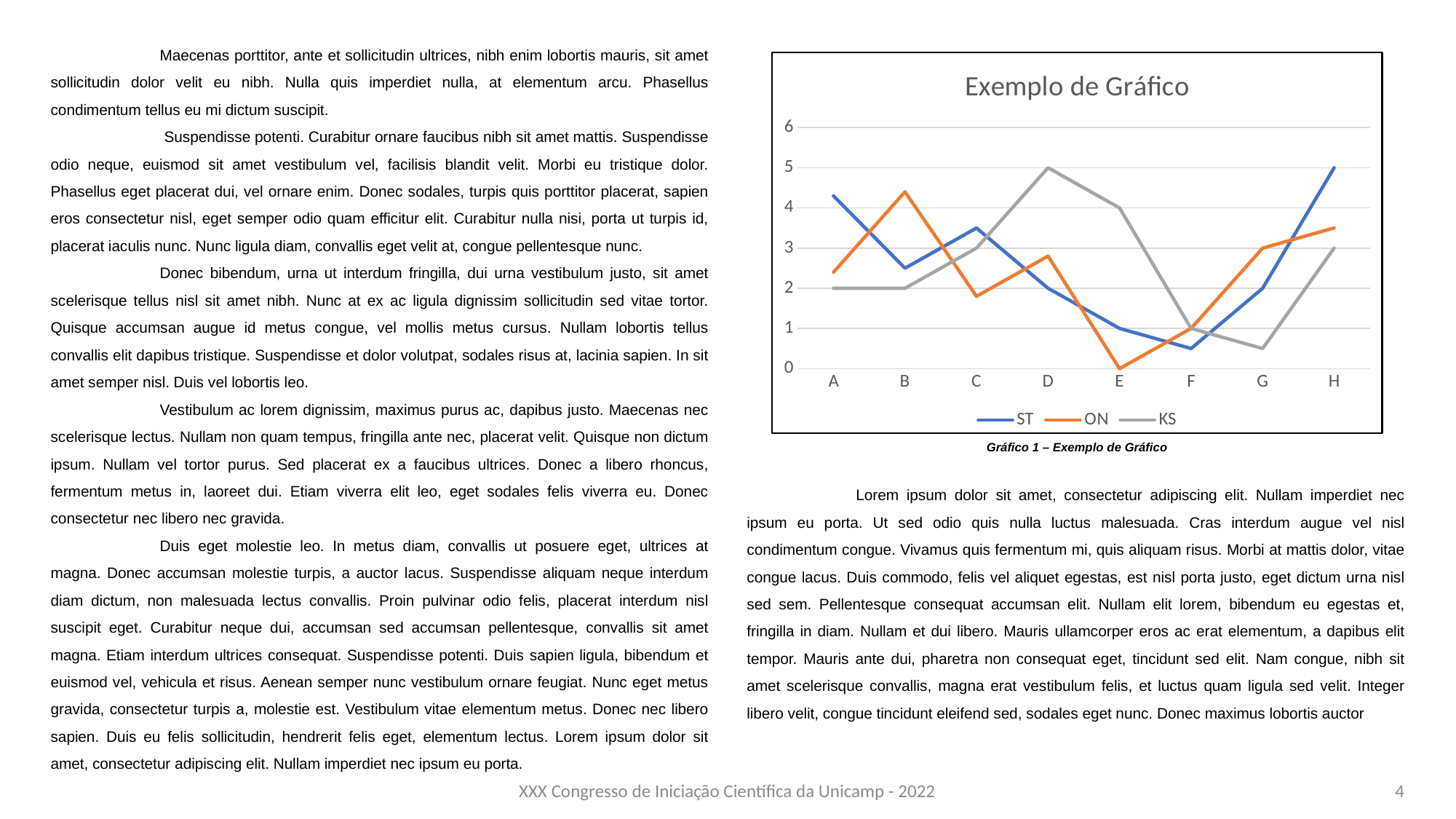
What is the value of the ON series at category E? 0 Is the value of the ST series at category A greater or less than 4? greater How many categories are shown on the x axis of the chart? 8 What kind of chart is shown on the slide? line chart What is the value of the ST series at category H? 5 At which category does the ST series reach its highest value? H At which category does the ON series reach its lowest value? E What is the value of the KS series at category D? 5 How many series does the legend of the chart list? 3 What is the title of the chart? Exemplo de Gráfico At category D, which series has the larger value, KS or ST? KS Does the ST series rise or fall from category A to category F? fall